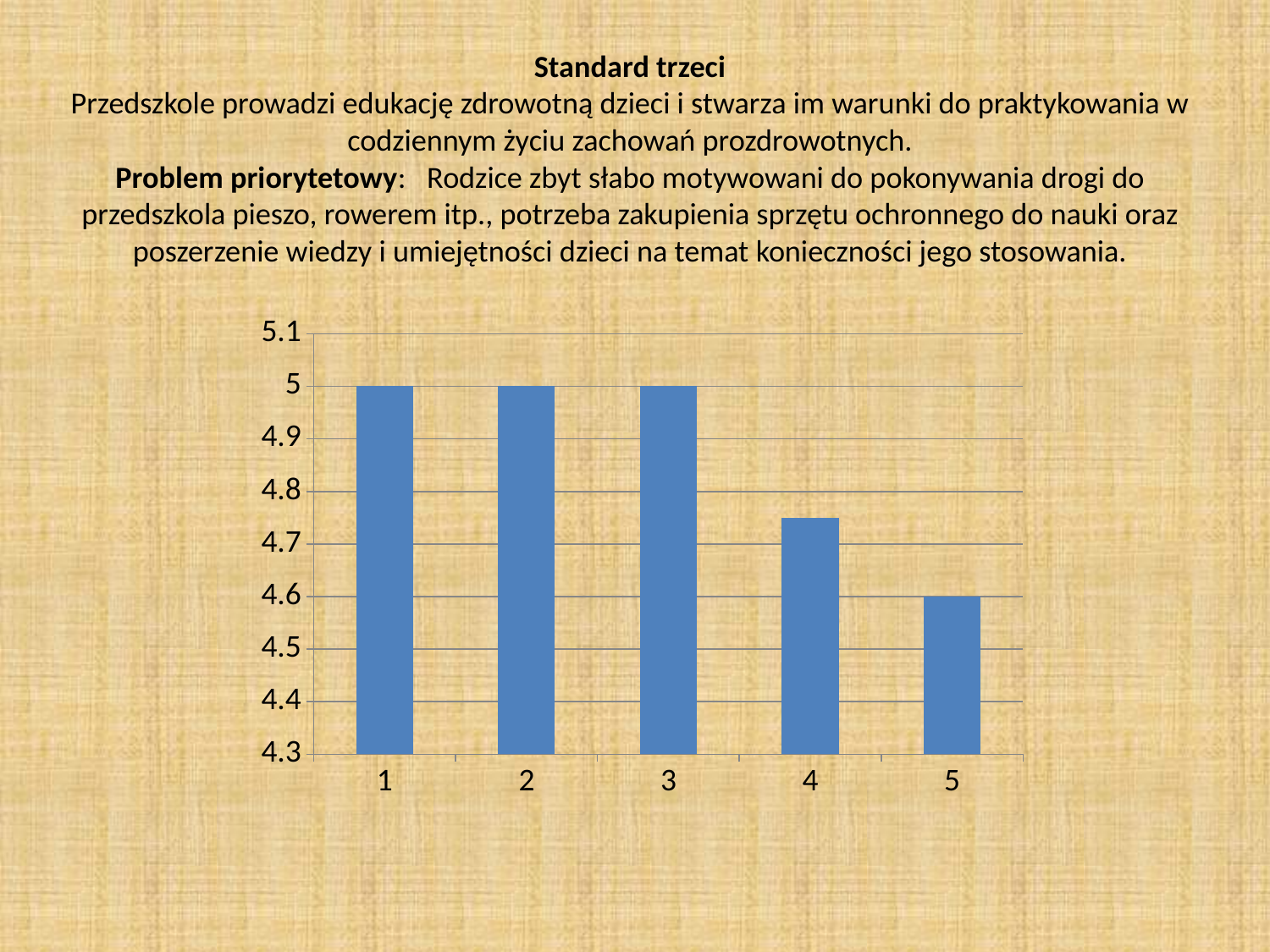
How many categories are shown on the x axis of the chart? 5 Do the values rise or fall from category 3 to category 5? fall Which is larger, the value for category 3 or the value for category 4? category 3 What colour are the bars in the chart? blue What is the value for category 5? 4.6 Which category has the lowest value? 5 Is the value for category 4 greater or less than 4.7? greater What is the value for category 3? 5 What kind of chart is shown on the slide? bar chart What is the difference between the value for category 1 and the value for category 5? 0.4 Is the value for category 4 greater or less than 4.8? less What is the value for category 1? 5